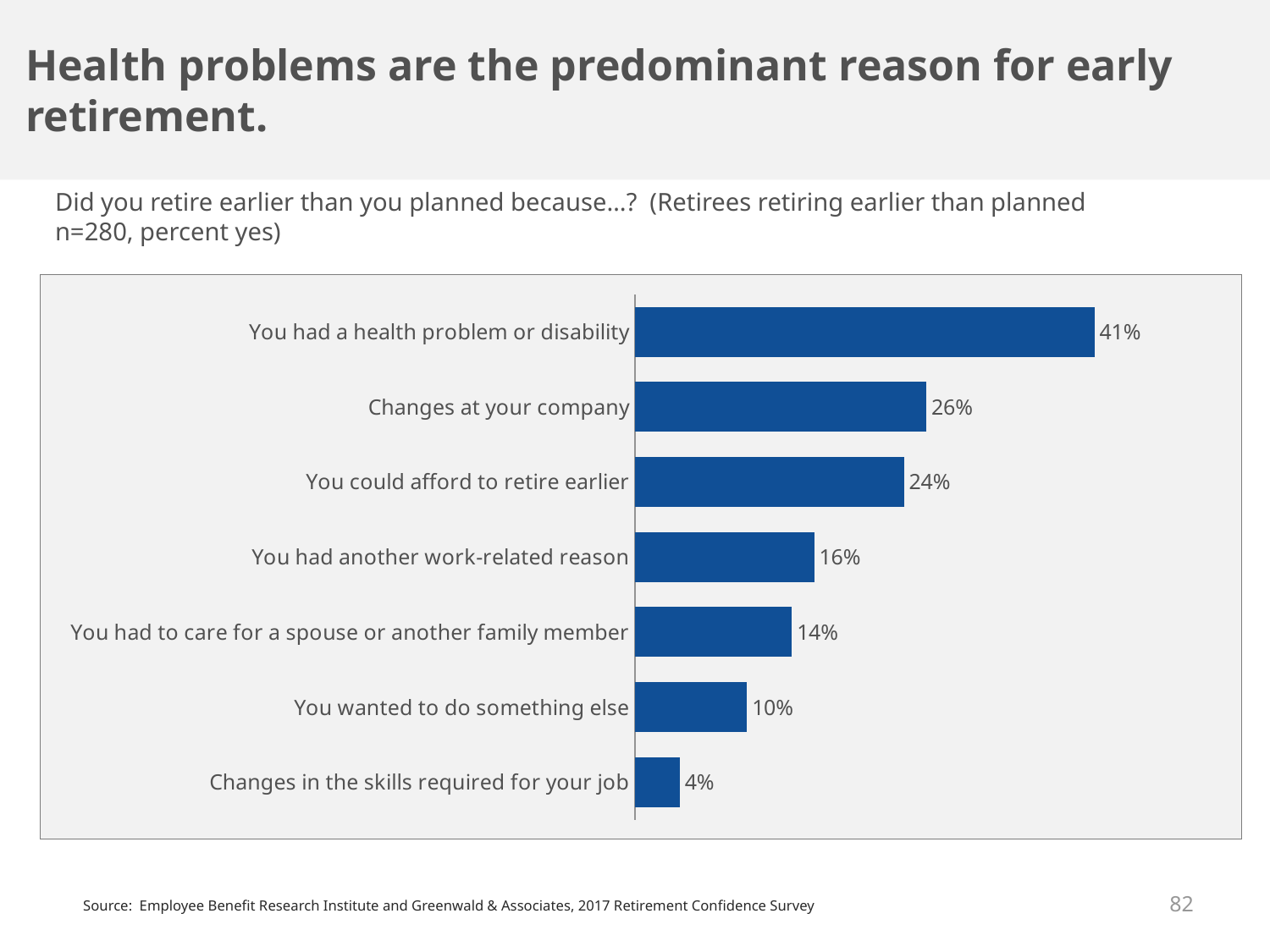
Which is larger: 'You could afford to retire earlier' or 'You had another work-related reason'? You could afford to retire earlier What type of chart is shown on the slide? Bar chart Which reason has the highest percentage? You had a health problem or disability How many reasons are shown in the chart? 7 What is the difference between 'You could afford to retire earlier' and 'You had another work-related reason'? 8 What is the difference in percentage points between 'You had a health problem or disability' and 'Changes at your company'? 15 Which reason has the lowest percentage? Changes in the skills required for your job What percentage said they retired early because they had to care for a spouse or another family member? 14% What is the value for 'Changes at your company'? 26% What is the sample size (n) stated for retirees retiring earlier than planned? 280 What is the value for 'You wanted to do something else'? 10% What percentage of retirees said they retired earlier than planned because they had a health problem or disability? 41%